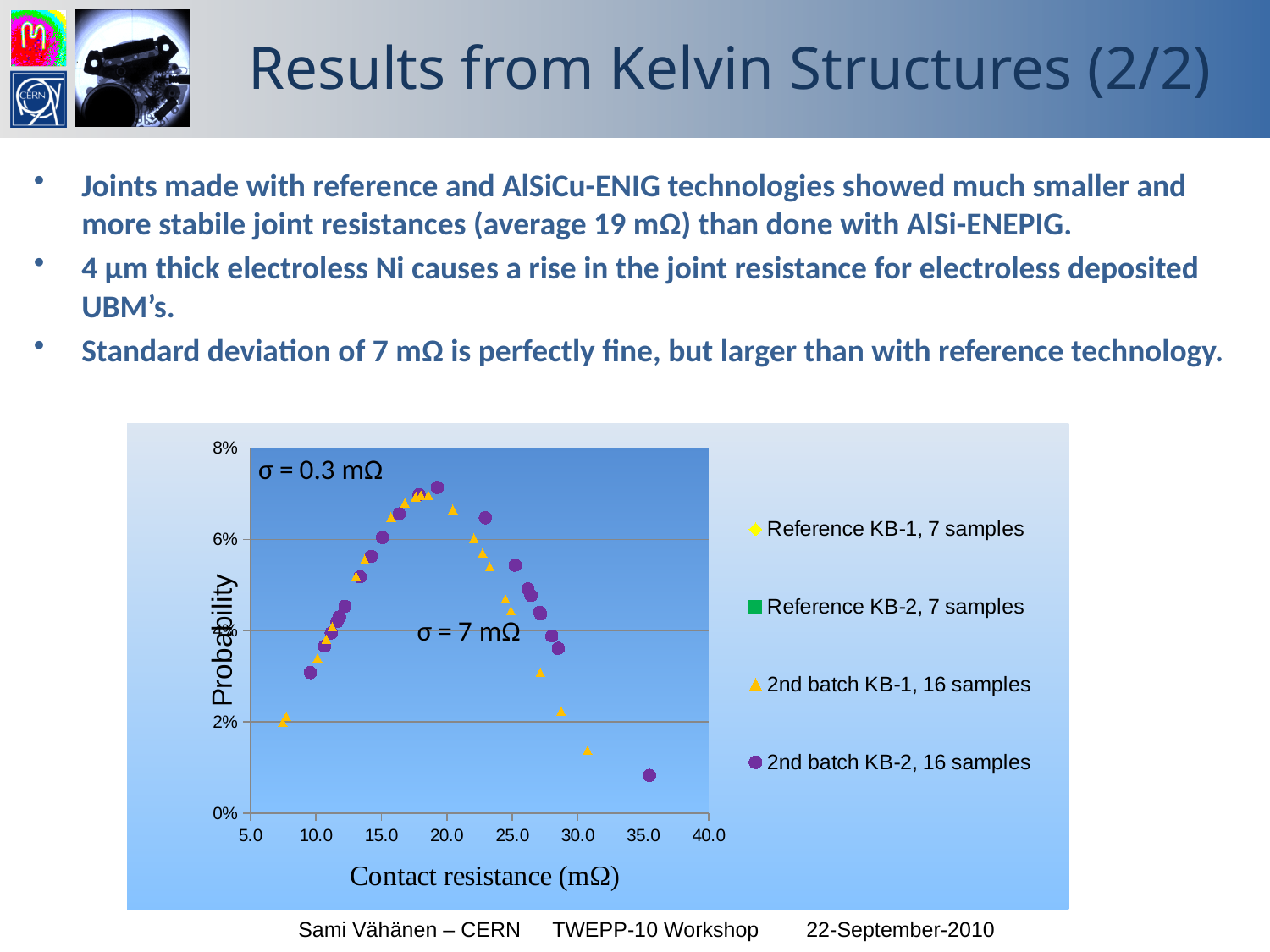
How many series does the chart legend list? 4 What is the maximum value shown on the x axis of the chart? 40.0 How many samples does the legend state for the 'Reference KB-1' series? 7 samples What is the maximum value shown on the y axis of the chart? 8% What standard deviation is annotated for the wider 2nd batch distribution in the chart? σ = 7 mΩ What kind of chart is shown on the slide? Scatter chart Is the probability of the '2nd batch KB-2' point plotted near 35 mΩ greater or less than 2%? less Is the highest probability value plotted for the '2nd batch KB-2, 16 samples' series greater or less than 6%? greater How many samples does the legend state for the '2nd batch KB-1' series? 16 samples What is the title of the y axis of the chart? Probability What standard deviation is annotated next to the narrow peak of the reference series in the chart? σ = 0.3 mΩ What is the title of the x axis of the chart? Contact resistance (mΩ)